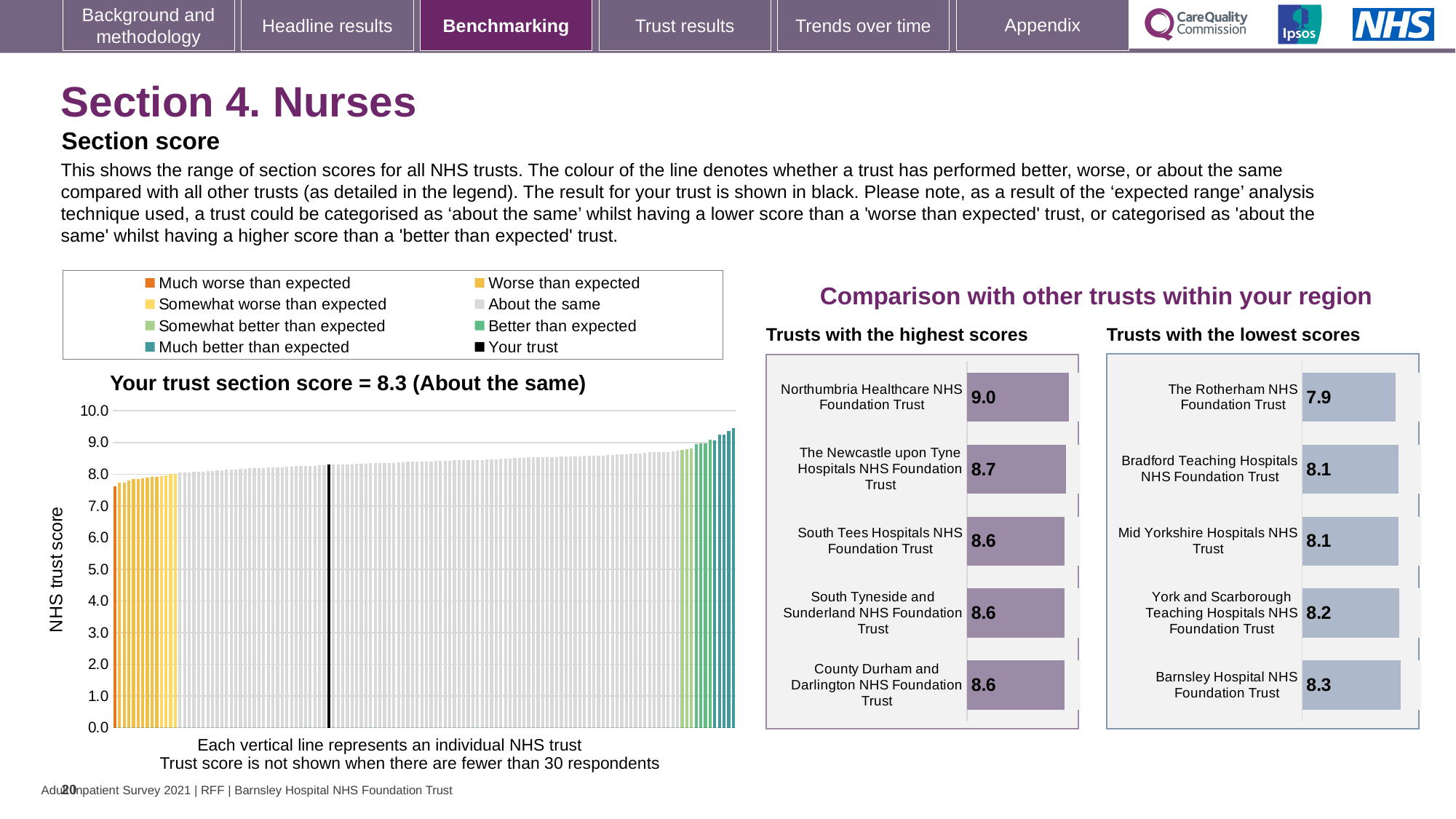
In the 'Trusts with the highest scores' chart, which trust has the highest score? Northumbria Healthcare NHS Foundation Trust In the 'Trusts with the lowest scores' chart, what is the score for Barnsley Hospital NHS Foundation Trust? 8.3 What kind of chart is the 'Your trust section score' chart? Bar chart In the 'Your trust section score' chart, what is the label on the vertical axis? NHS trust score In the 'Your trust section score' chart, what is the section score for your trust? 8.3 In the 'Trusts with the lowest scores' chart, which trust has the lowest score? The Rotherham NHS Foundation Trust In the 'Trusts with the highest scores' chart, what is the difference between the scores of Northumbria Healthcare NHS Foundation Trust and The Newcastle upon Tyne Hospitals NHS Foundation Trust? 0.3 In the 'Your trust section score' chart, do the bar values rise or fall from left to right? Rise In the 'Trusts with the highest scores' chart, what is the score for Northumbria Healthcare NHS Foundation Trust? 9.0 In the 'Your trust section score' chart, how many entries does the legend list? 8 In the 'Trusts with the lowest scores' chart, how many trusts are shown? 5 In the 'Your trust section score' chart, is the value of the tallest bar greater or less than 9.0? greater